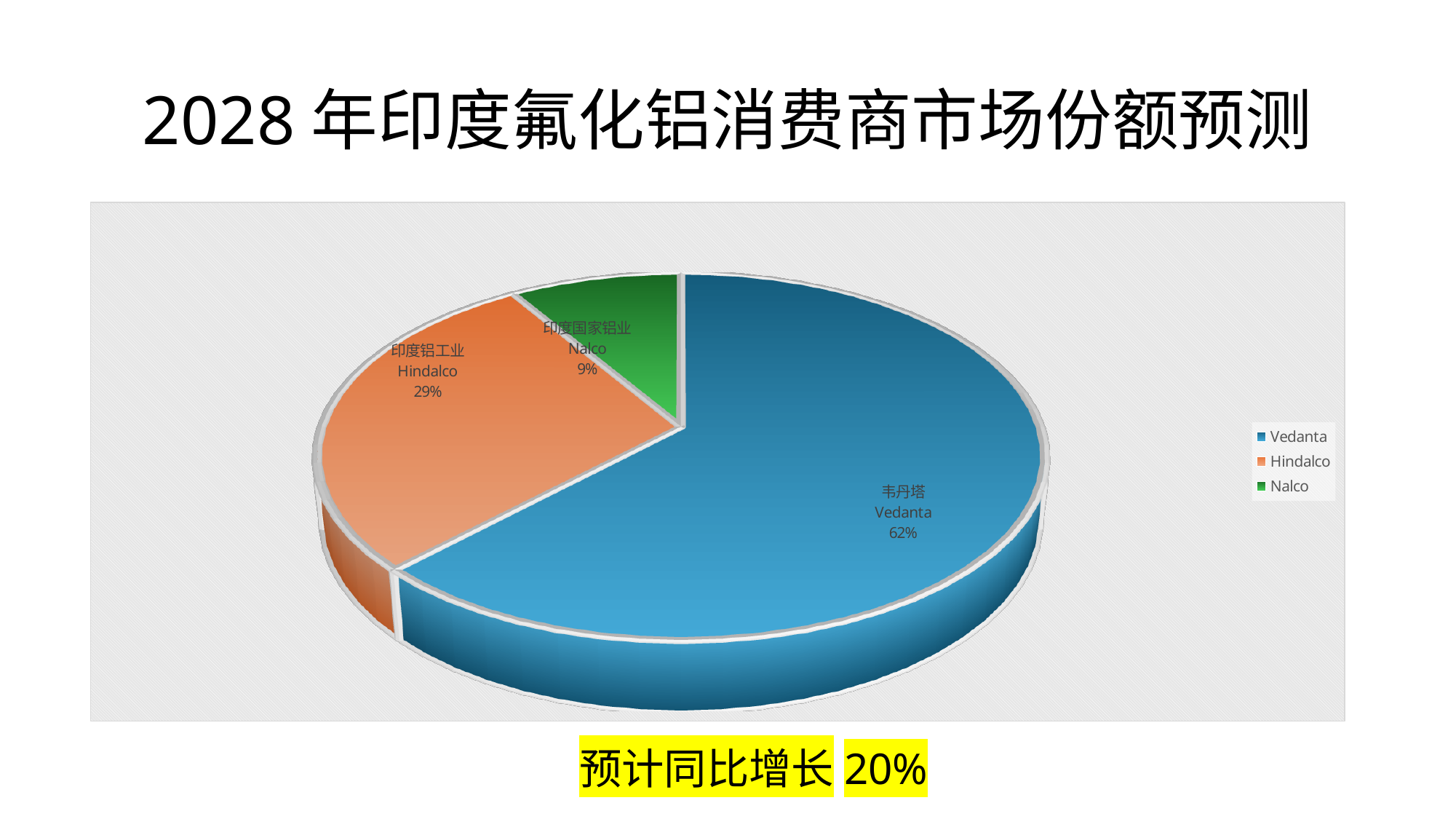
Which company has the smallest market share? Nalco What share of the pie does Nalco hold? 9% Which has a larger market share, Hindalco or Nalco? Hindalco What is the difference in market share between Vedanta and Hindalco? 33% What share of the pie does Hindalco hold? 29% What is the difference in market share between Hindalco and Nalco? 20% What colour is the Nalco slice? Green How many entries does the legend list? 3 How many companies are shown in the pie chart? 3 What share of the pie does Vedanta hold? 62% What kind of chart is shown on the slide? Pie chart Which company has the largest market share? Vedanta